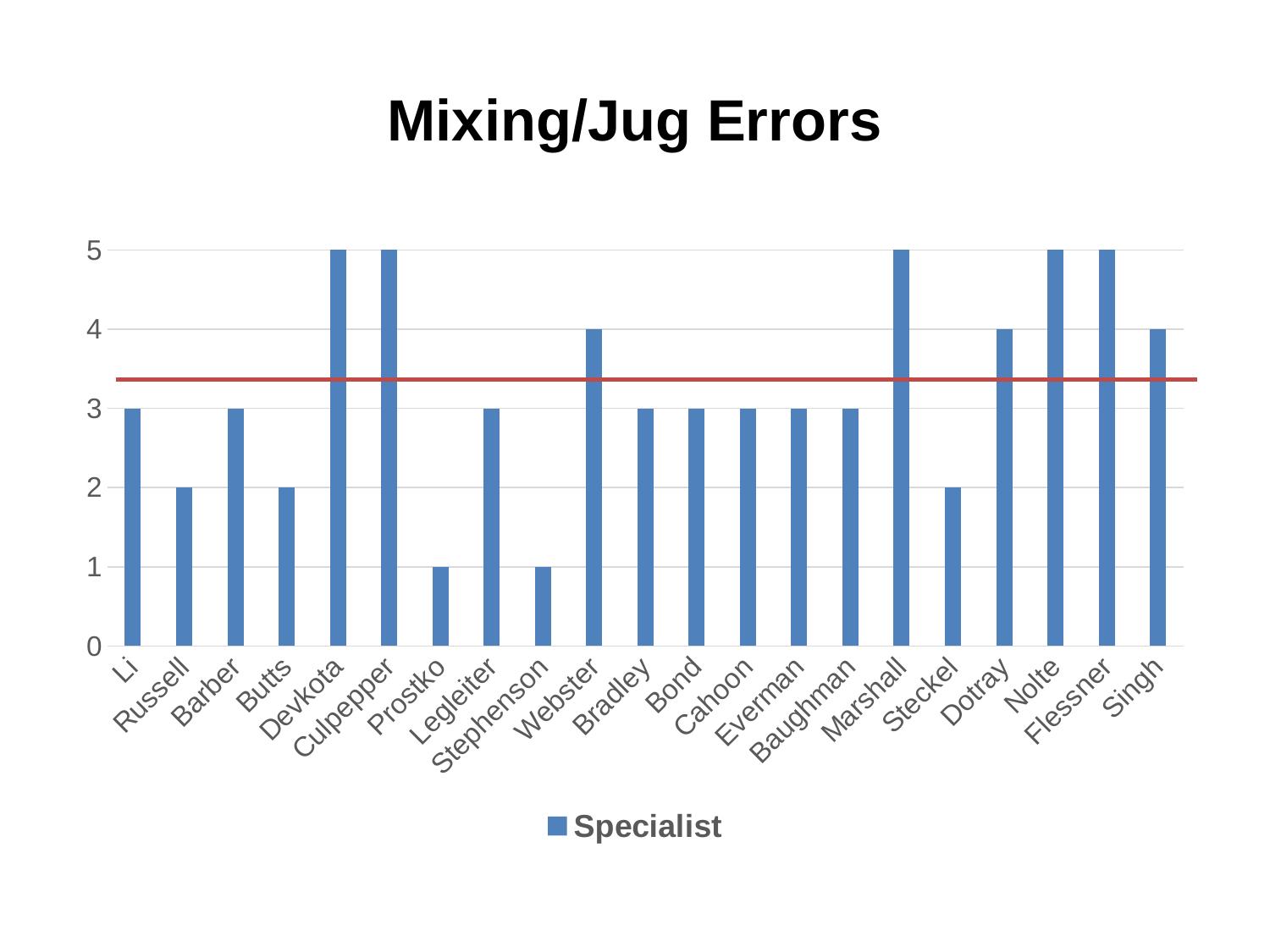
What is the title of the chart? Mixing/Jug Errors How many series does the legend list? 1 Is the value for Nolte greater or less than 4? greater Which has a larger value, Marshall or Bradley? Marshall What is the difference between the values for Culpepper and Li? 2 What is the value for Prostko? 1 What is the value for Devkota? 5 What is the value for Webster? 4 What kind of chart is shown on the slide? bar chart What is the name of the series shown in the legend? Specialist What is the value for Steckel? 2 How many categories (specialists) are shown on the x axis? 21